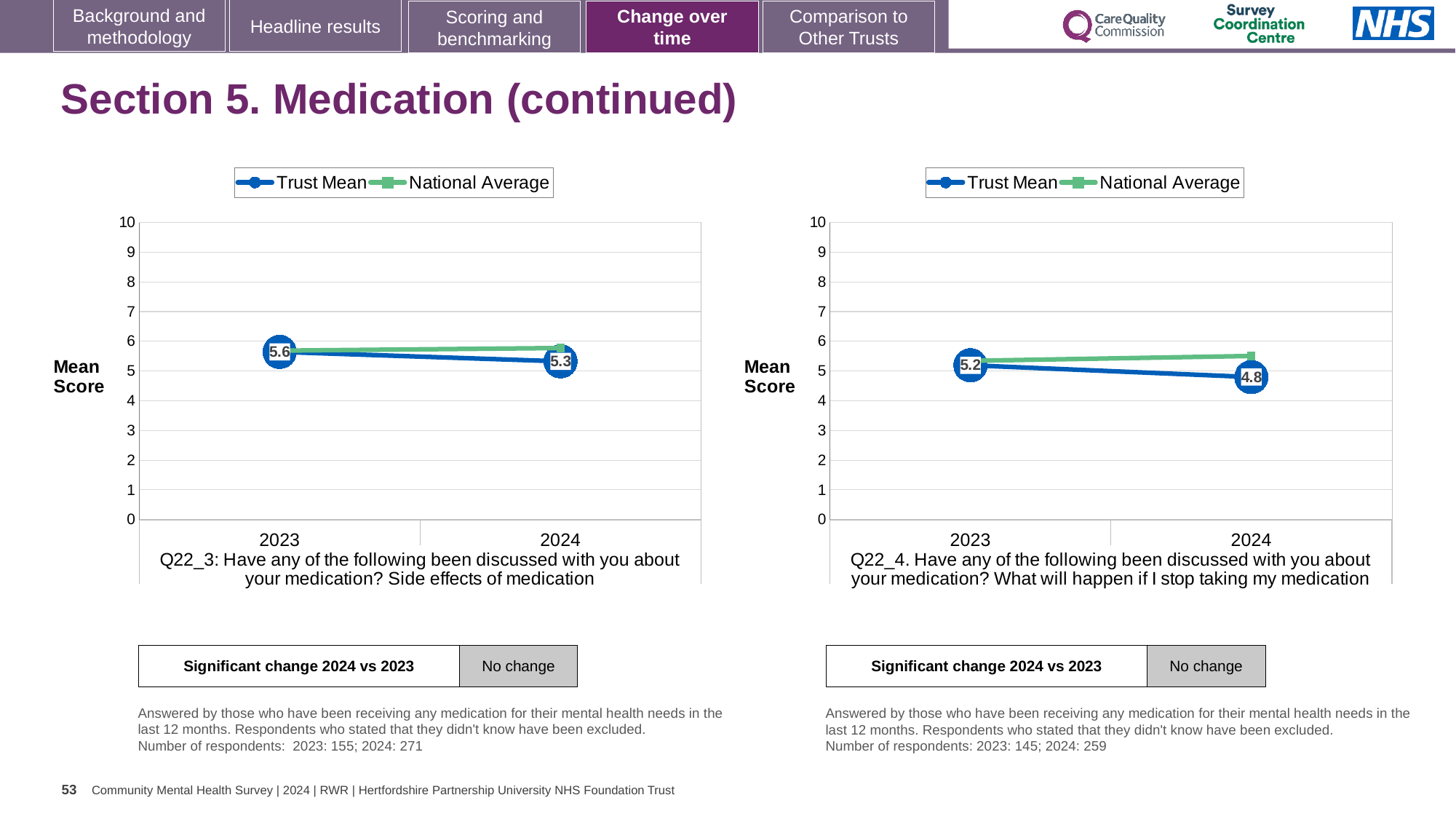
In the right chart (Q22_4), is the Trust Mean for 2024 greater or less than 5? less In the right chart (Q22_4), what is the difference between the Trust Mean in 2023 and 2024? 0.4 What kind of chart is the right chart (Q22_4)? line chart In the right chart (Q22_4), what is the Trust Mean for 2024? 4.8 In the left chart (Q22_3), what is the Trust Mean for 2023? 5.6 How many years are plotted on the x axis of the left chart? 2 In the left chart (Q22_3), which year has the higher Trust Mean, 2023 or 2024? 2023 How many series does the legend of the left chart list? 2 In the left chart (Q22_3), by how much did the Trust Mean change from 2023 to 2024? 0.3 In the right chart (Q22_4), what is the Trust Mean for 2023? 5.2 In the right chart (Q22_4), does the Trust Mean rise or fall from 2023 to 2024? fall In the left chart (Q22_3), what is the Trust Mean for 2024? 5.3